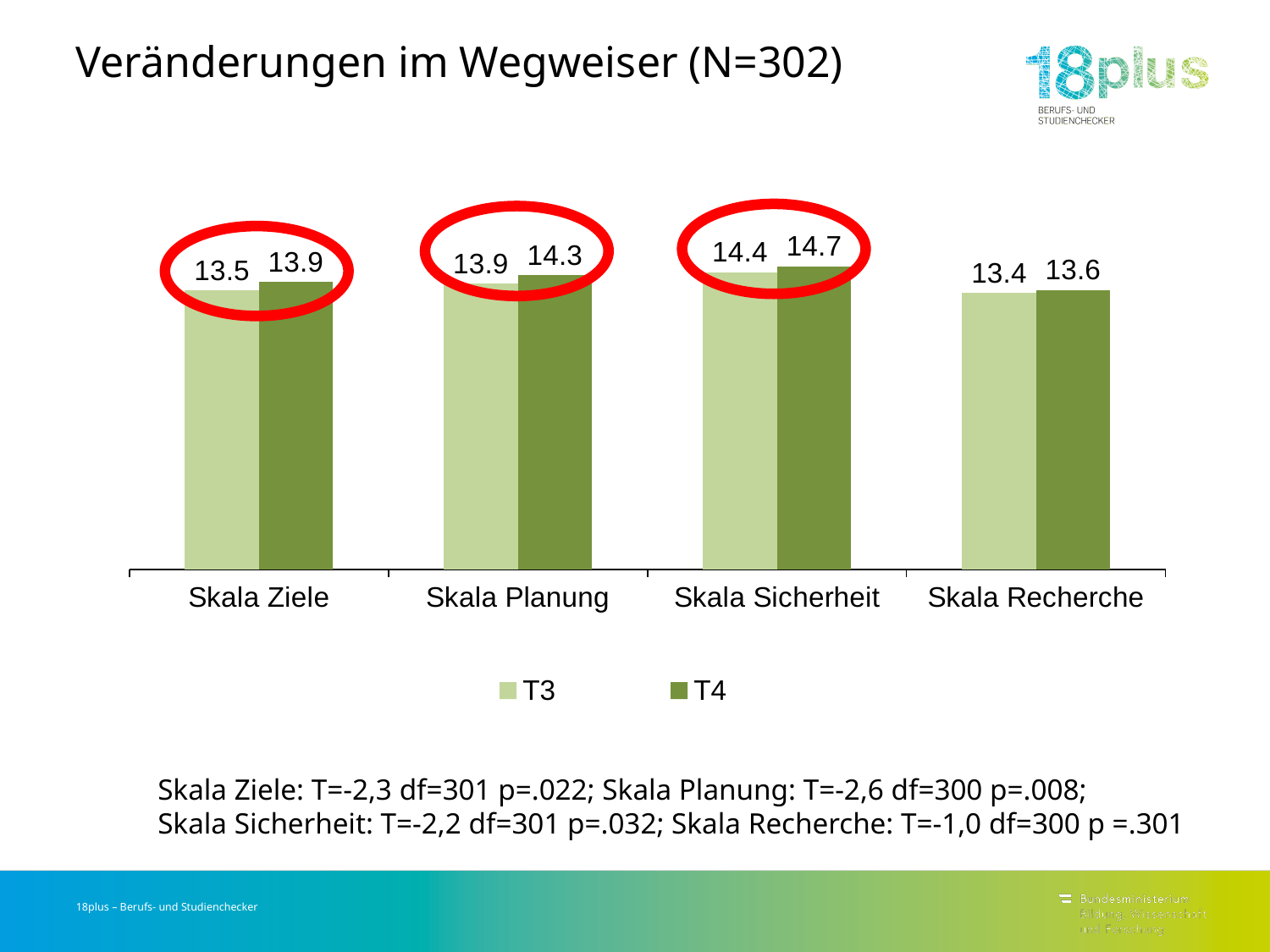
What kind of chart is shown on the slide? bar chart What is the difference between the T4 values for Skala Sicherheit and Skala Recherche? 1.1 What is the title of the slide containing the chart? Veränderungen im Wegweiser (N=302) Which category has the lowest T3 value? Skala Recherche How many categories are shown on the x axis? 4 What is the difference between the T4 and T3 values for Skala Ziele? 0.4 Which category has the highest T4 value? Skala Sicherheit Which is larger, the T3 value for Skala Planung or the T3 value for Skala Sicherheit? Skala Sicherheit What is the T3 value for Skala Recherche? 13.4 How many series does the legend list? 2 What is the T4 value for Skala Planung? 14.3 What is the T3 value for Skala Ziele? 13.5